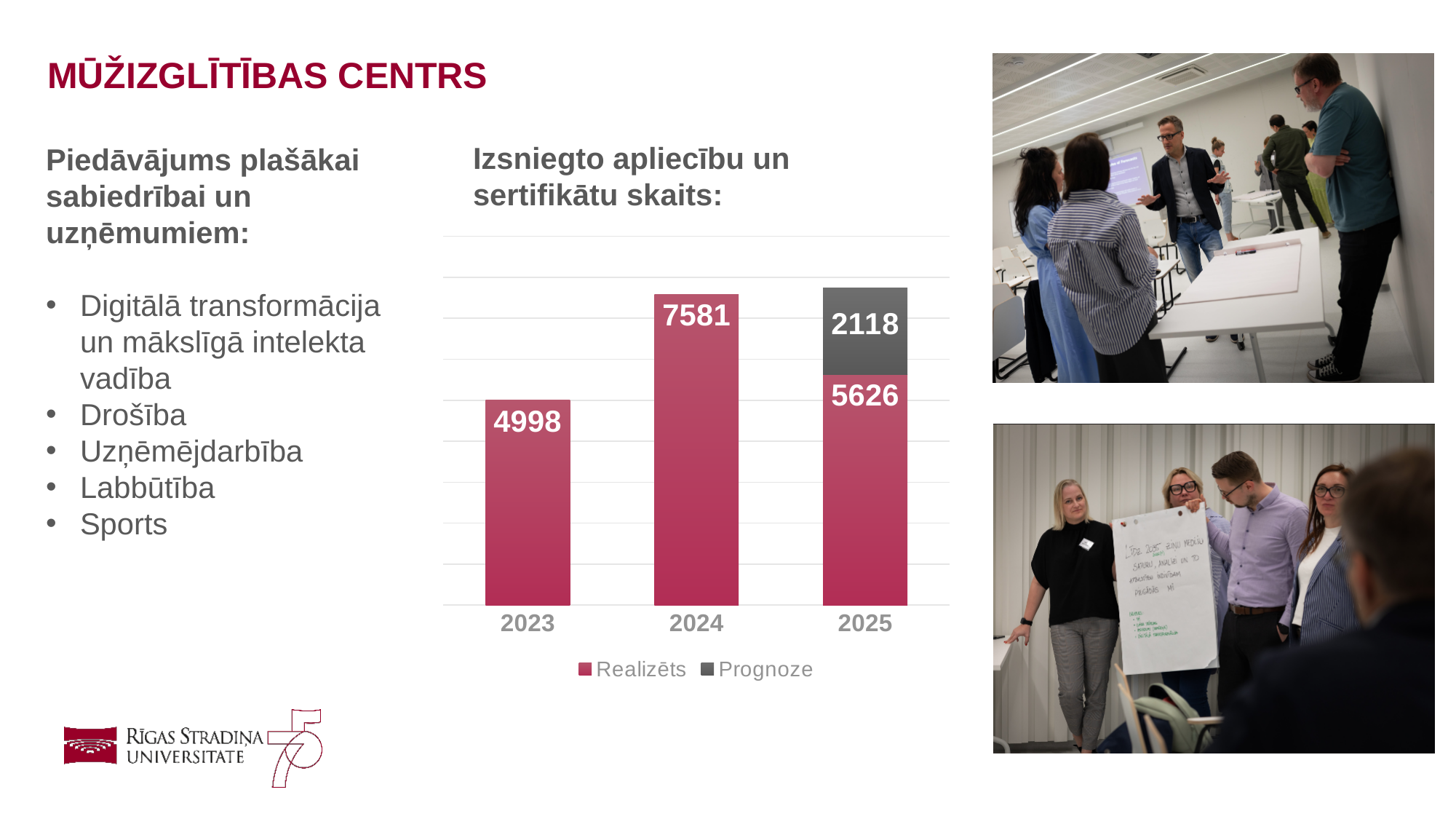
What is the difference between the Realizēts values for 2024 and 2023? 2583 What is the Prognoze value for 2025? 2118 Which year has the highest Realizēts value? 2024 Which year has the lowest Realizēts value? 2023 What is the Realizēts value for 2025? 5626 What is the Realizēts value for 2024? 7581 How many years are shown on the x axis of the chart? 3 How many series does the chart legend list? 2 Is the Realizēts value for 2025 larger or smaller than the Realizēts value for 2024? smaller What is the Realizēts value for 2023? 4998 What is the total of the stacked bar for 2025 (Realizēts plus Prognoze)? 7744 What kind of chart is shown on the slide? stacked bar chart